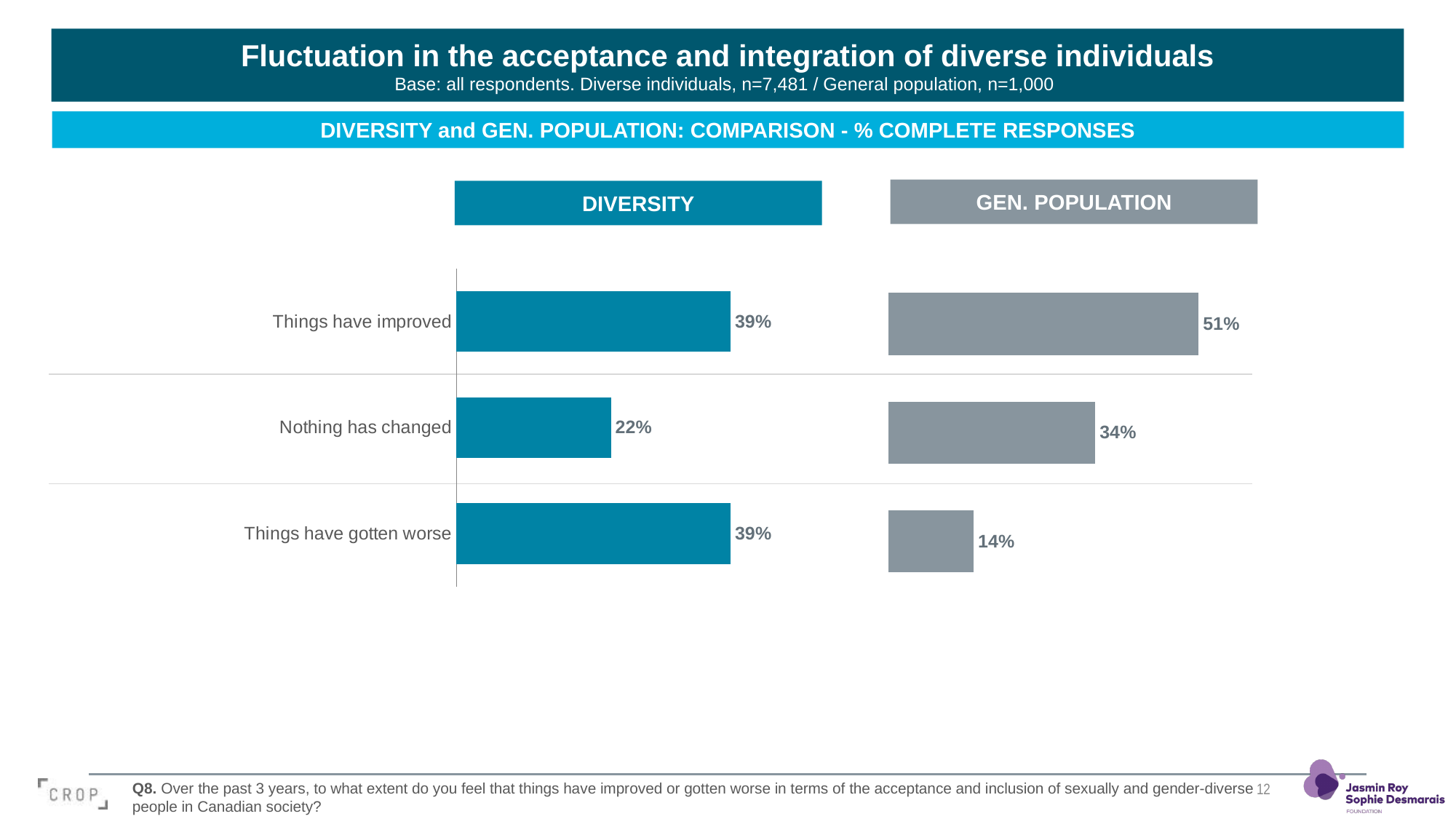
In the GEN. POPULATION chart, what is the value for "Things have gotten worse"? 14% In the DIVERSITY chart, what is the value for "Nothing has changed"? 22% In the DIVERSITY chart, what is the value for "Things have improved"? 39% In the DIVERSITY chart, which category has the lowest value? Nothing has changed In the GEN. POPULATION chart, what is the value for "Nothing has changed"? 34% How many categories are shown in the DIVERSITY chart? 3 What is the difference between the DIVERSITY and GEN. POPULATION values for "Things have gotten worse"? 25 percentage points What type of chart is used on this slide? Bar chart In the GEN. POPULATION chart, which category has the highest value? Things have improved What is the difference between the GEN. POPULATION and DIVERSITY values for "Things have improved"? 12 percentage points For "Nothing has changed", which is larger: the DIVERSITY value or the GEN. POPULATION value? GEN. POPULATION In the GEN. POPULATION chart, which category has the lowest value? Things have gotten worse